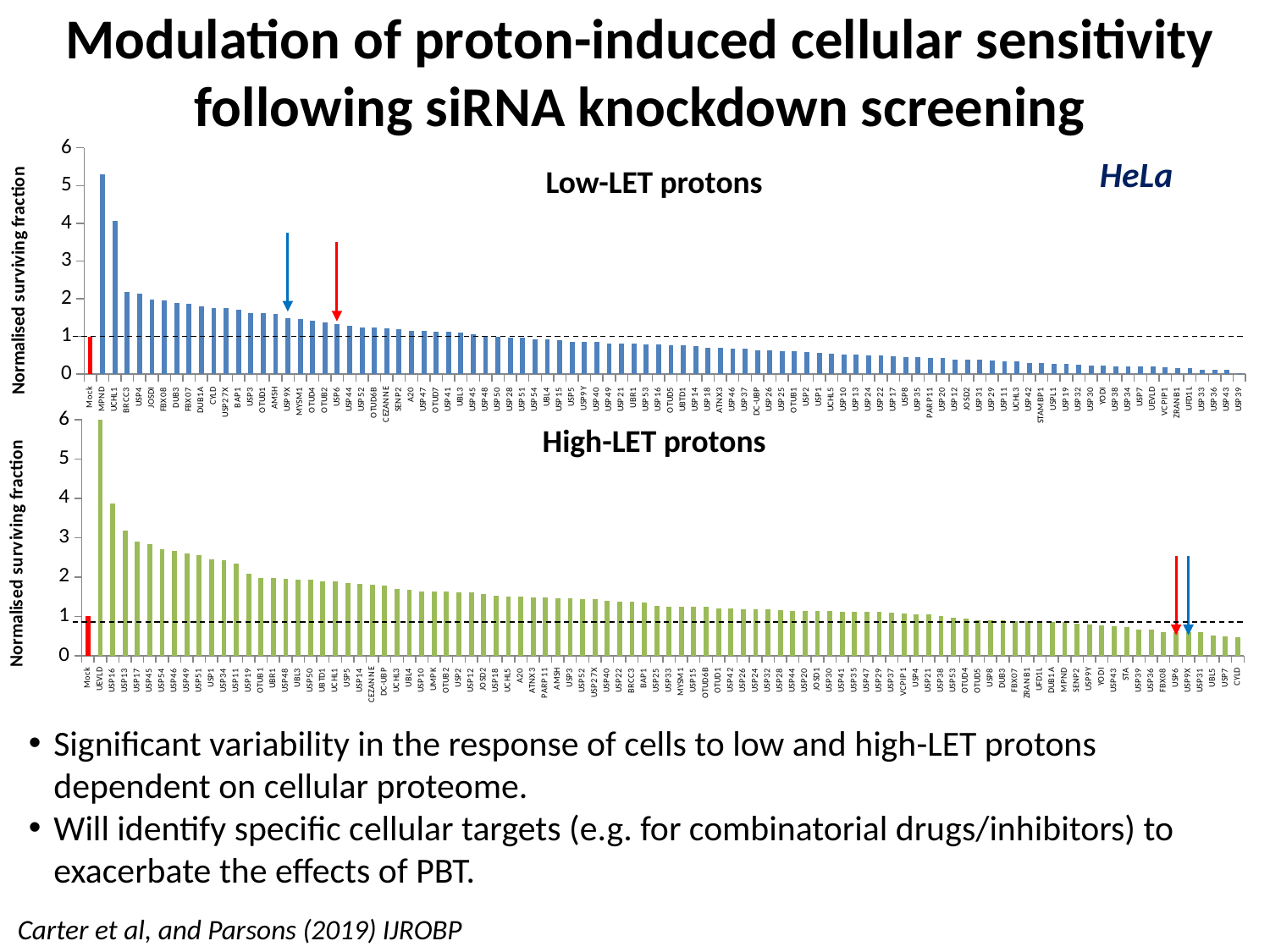
What is the y-axis label of the Low-LET protons chart? Normalised surviving fraction In the High-LET protons chart, do the bar values rise or fall from left to right along the x axis? fall What kind of chart is the Low-LET protons chart? bar chart In the High-LET protons chart, is the value for CYLD greater or less than 1? less In the Low-LET protons chart, is the value for UCHL1 greater or less than 3? greater In the High-LET protons chart, is the value for USP16 greater or less than 3? greater In the High-LET protons chart, what colour is the Mock bar? red In the High-LET protons chart, which category has the highest normalised surviving fraction? UEVLD In the Low-LET protons chart, which category has the lowest normalised surviving fraction? USP39 In the Low-LET protons chart, which category has the highest normalised surviving fraction? MPND In the Low-LET protons chart, which is larger, the value for MPND or the value for UCHL1? MPND